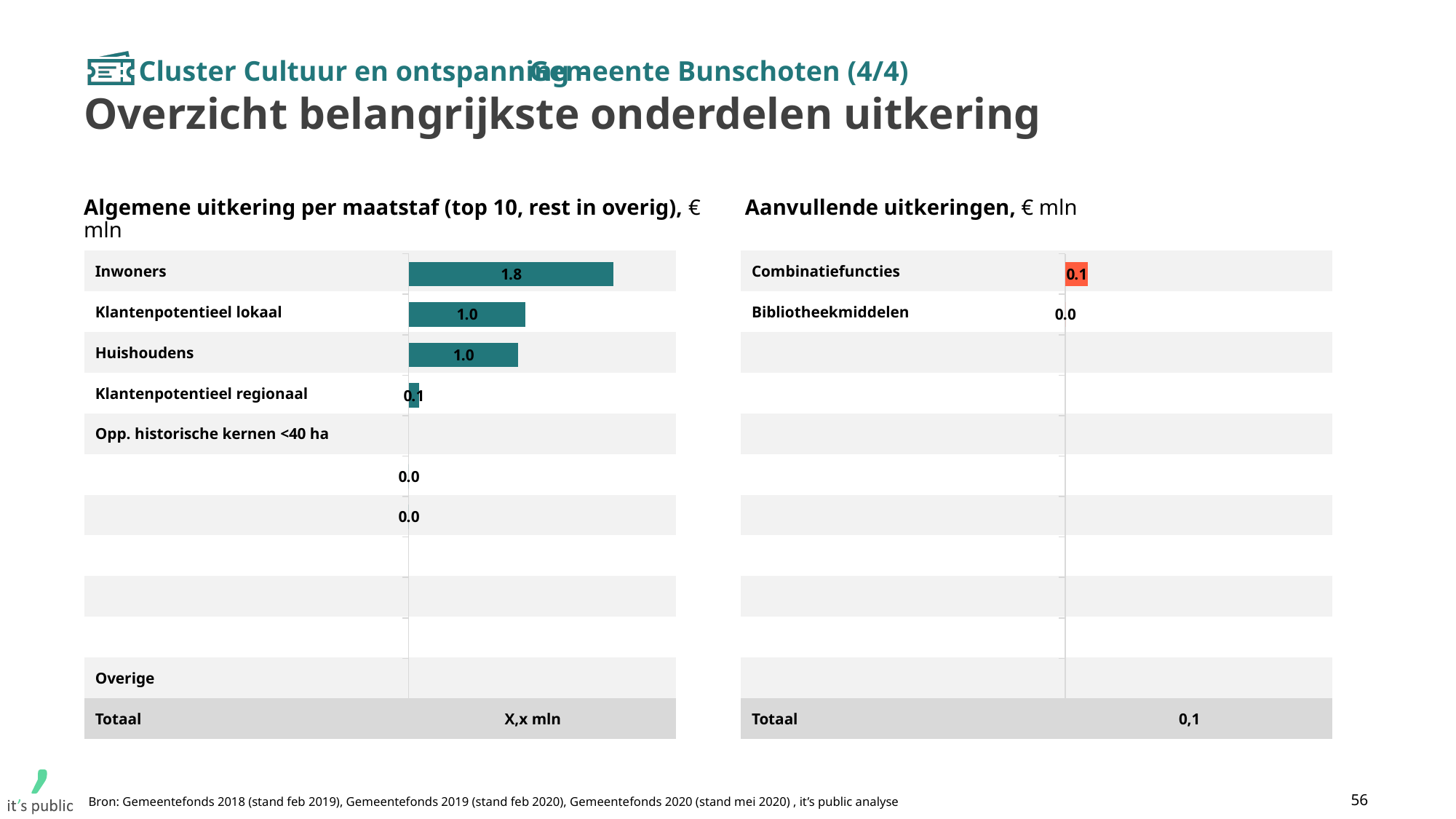
In the chart 'Aanvullende uitkeringen', what is the value for Combinatiefuncties? 0.1 In the chart 'Algemene uitkering per maatstaf', which is larger: the value for Inwoners or the value for Klantenpotentieel regionaal? Inwoners In the chart 'Aanvullende uitkeringen', what is the value for Bibliotheekmiddelen? 0.0 In the chart 'Algemene uitkering per maatstaf', what is the value for Huishoudens? 1.0 In the chart 'Algemene uitkering per maatstaf', what is the value for Inwoners? 1.8 In the chart 'Algemene uitkering per maatstaf', what is the difference between the values for Inwoners and Klantenpotentieel lokaal? 0.8 In the chart 'Algemene uitkering per maatstaf', which category has the highest value? Inwoners In the chart 'Aanvullende uitkeringen', what is the Totaal shown at the bottom? 0,1 What colour is the bar for Combinatiefuncties in the chart 'Aanvullende uitkeringen'? orange-red What kind of chart is the 'Algemene uitkering per maatstaf' chart on the left? bar chart In the chart 'Algemene uitkering per maatstaf', what is the value for Klantenpotentieel regionaal? 0.1 In the chart 'Algemene uitkering per maatstaf', what is the value for Klantenpotentieel lokaal? 1.0